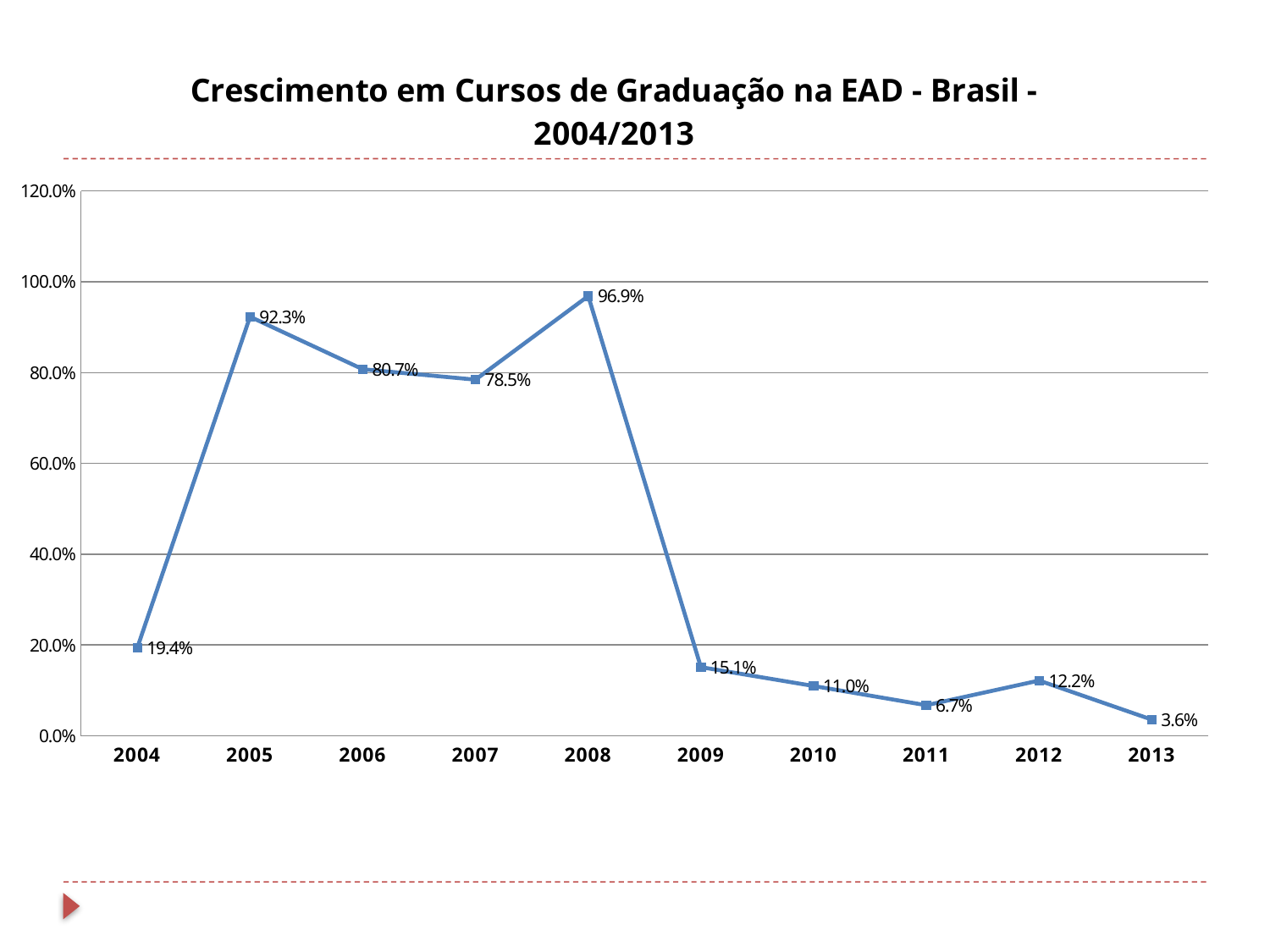
Is the value for 2007 greater or less than 80.0%? less Which year has the highest value? 2008 What is the difference between the values for 2008 and 2009? 81.8% What kind of chart is shown on the slide? line chart How many years are plotted on the chart? 10 Which year has the lowest value? 2013 What is the difference between the values for 2005 and 2006? 11.6% Do the values rise or fall from 2008 to 2009? fall What is the value for 2011? 6.7% What is the value for 2004? 19.4% Which is larger, the value for 2010 or the value for 2012? 2012 What is the value for 2008? 96.9%